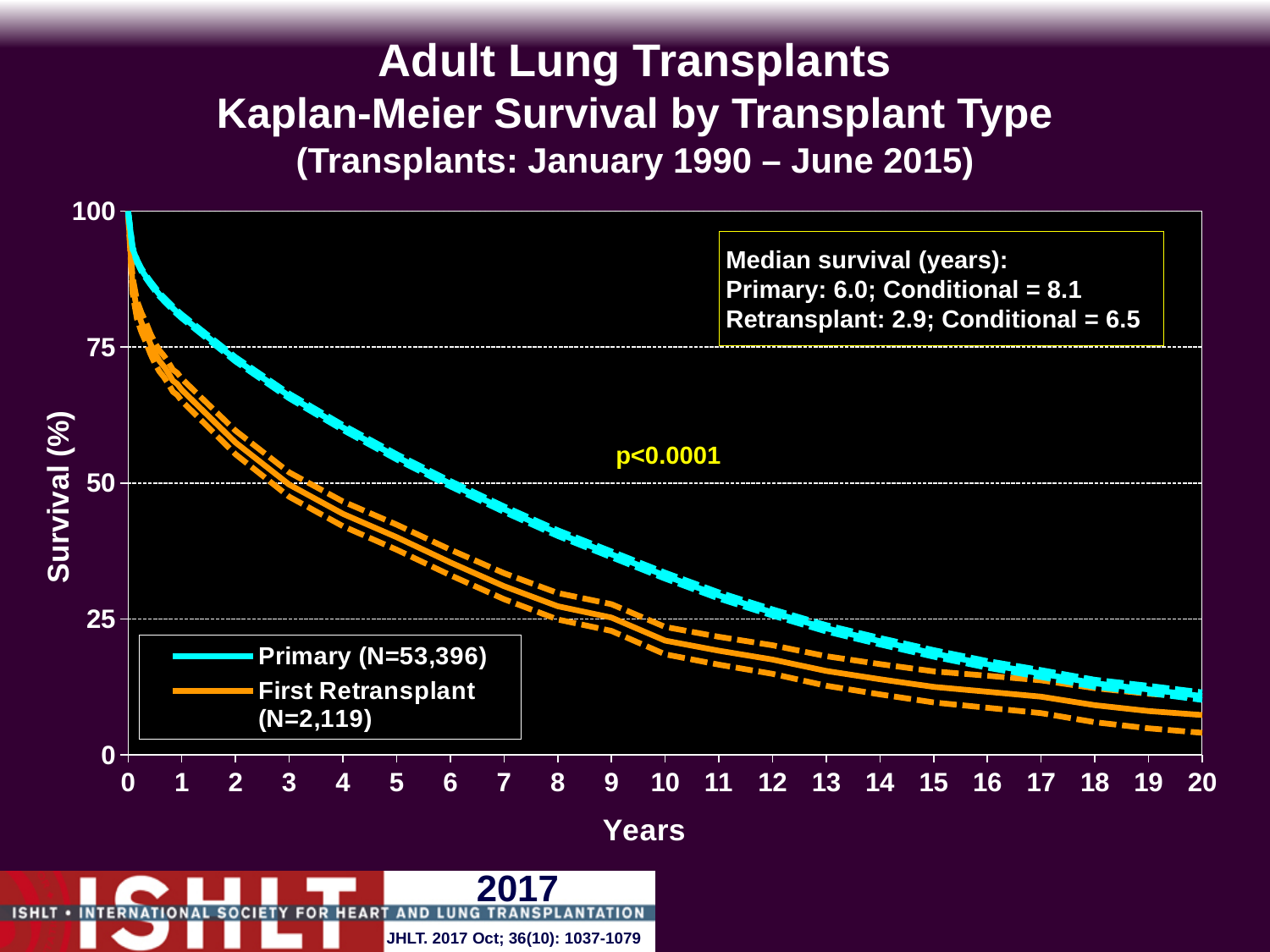
Is the survival for First Retransplant at 10 years greater or less than 25? less What is the conditional median survival in years for Primary transplants? 8.1 What is the N for the Primary series shown in the legend? 53,396 What is the median survival in years for Retransplant, as stated in the text box? 2.9 What is the difference in median survival (years) between Primary and Retransplant? 3.1 What kind of chart is shown on the slide? line chart Do the survival curves rise or fall as years increase? fall How many series does the legend list? 2 Which series has higher survival at 5 years, Primary or First Retransplant? Primary What p-value is printed on the chart? p<0.0001 Is the survival for Primary at 5 years greater or less than 50? greater What is the median survival in years for Primary transplants, as stated in the text box? 6.0